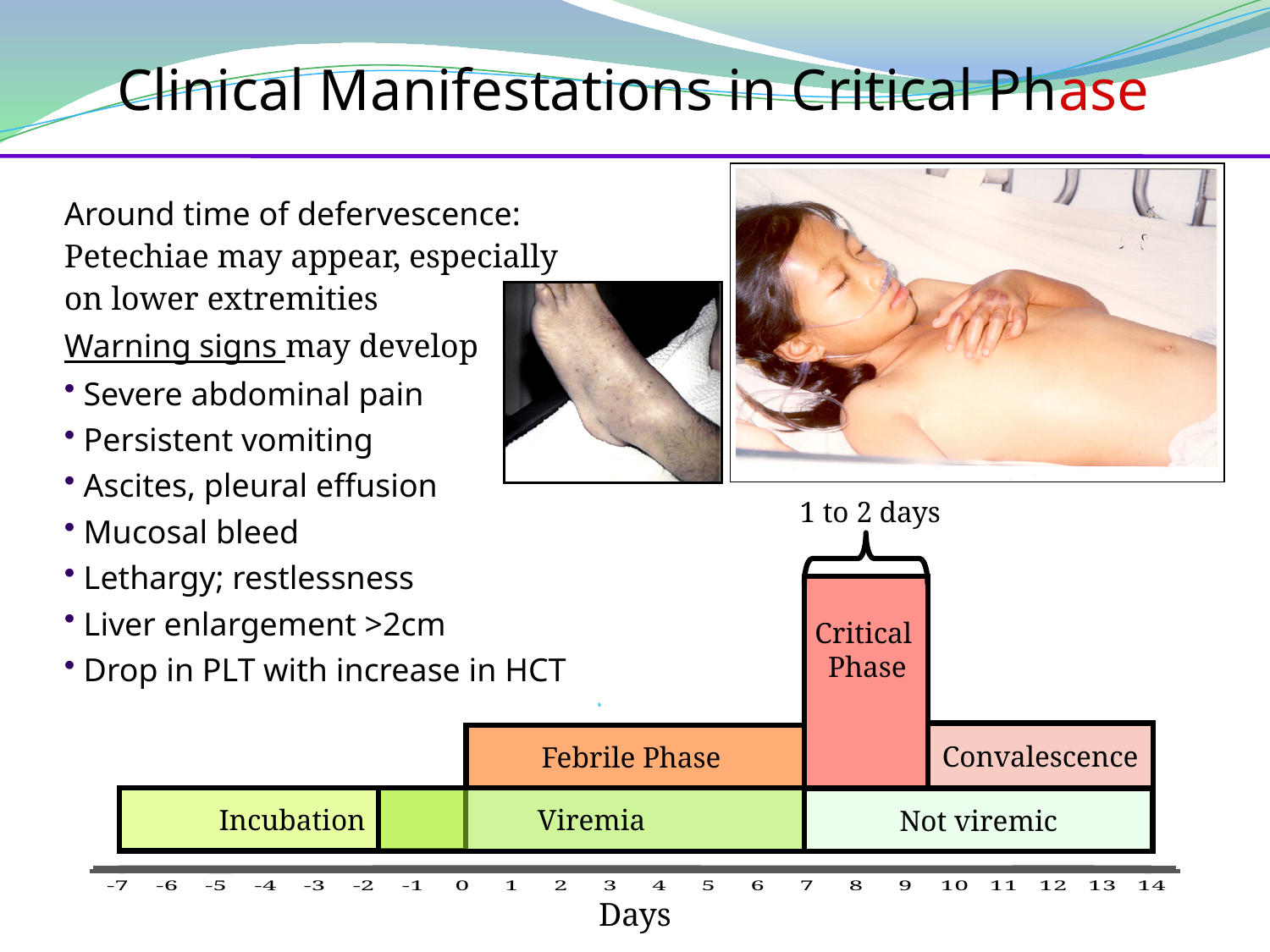
What is the lowest value shown on the Days axis of the timeline chart? -7 On the timeline chart, which bottom-row segment covers days 7 to 14? Not viremic On the timeline chart, which is longer: the Febrile Phase or the Critical Phase? Febrile Phase On the timeline chart, at which day does the Febrile Phase begin? 0 On the timeline chart, which phase comes immediately after the Critical Phase? Convalescence On the timeline chart, at which day does the Critical Phase begin? 7 On the timeline chart, which phase is shown in the bottom row before Viremia? Incubation What is the label on the horizontal axis of the timeline chart? Days How many labelled phase segments are shown in the timeline chart? 6 What is the highest value shown on the Days axis of the timeline chart? 14 How long does the timeline chart say the Critical Phase lasts? 1 to 2 days